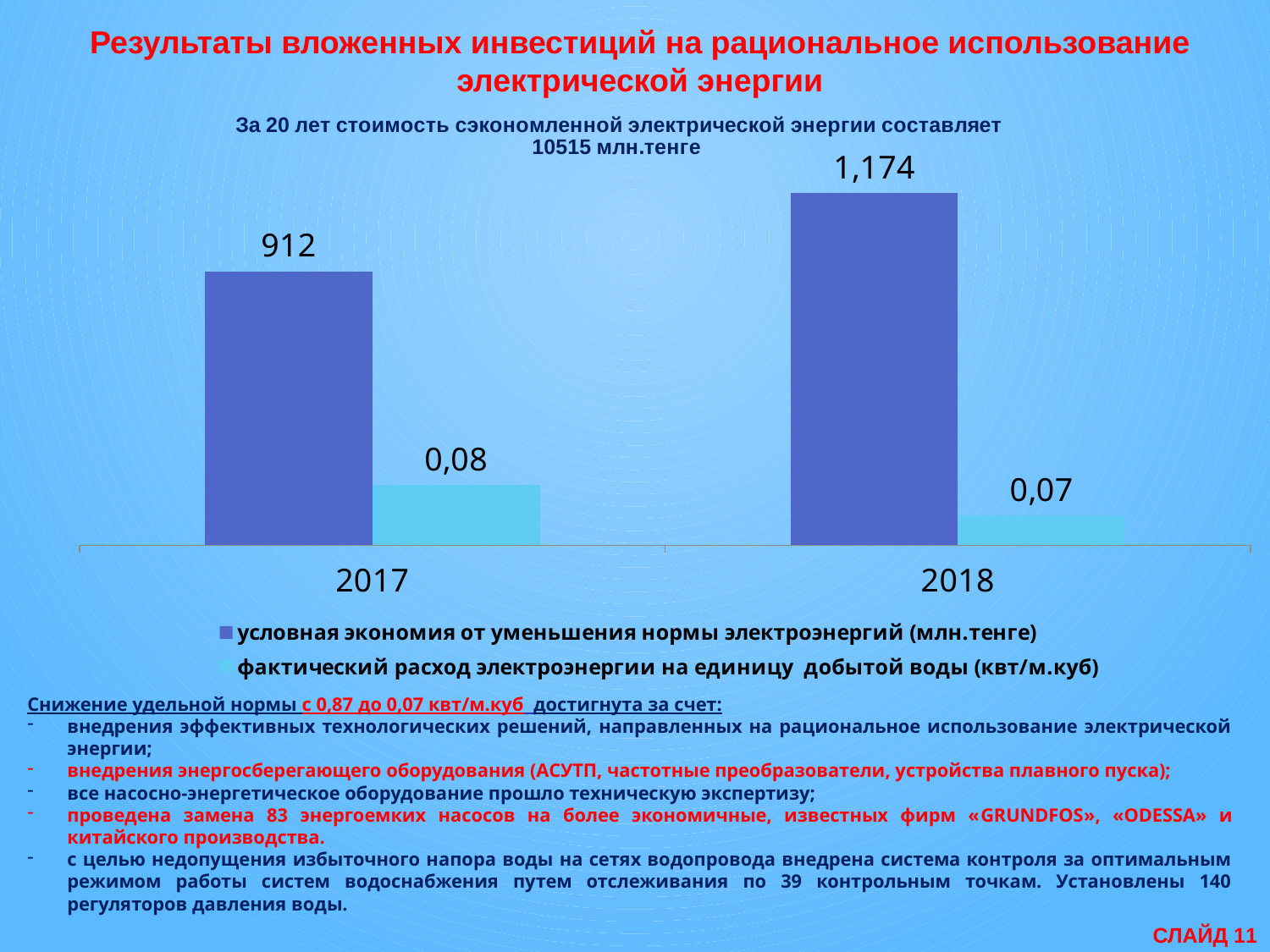
Does условная экономия от уменьшения нормы электроэнергий rise or fall from 2017 to 2018? Rise What type of chart is shown on the slide? Bar chart What is the value of условная экономия от уменьшения нормы электроэнергий (млн.тенге) for 2018? 1,174 What is the value of фактический расход электроэнергии на единицу добытой воды (квт/м.куб) for 2018? 0,07 What is the value of условная экономия от уменьшения нормы электроэнергий (млн.тенге) for 2017? 912 What is the value of фактический расход электроэнергии на единицу добытой воды (квт/м.куб) for 2017? 0,08 In which year is условная экономия от уменьшения нормы электроэнергий (млн.тенге) higher? 2018 Which is larger: условная экономия in 2017 or in 2018? 2018 By how much did фактический расход электроэнергии на единицу добытой воды (квт/м.куб) decrease from 2017 to 2018? 0,01 In which year is фактический расход электроэнергии на единицу добытой воды (квт/м.куб) lower? 2018 How many years (categories) are shown on the x axis of the chart? 2 How many series does the chart legend list? 2